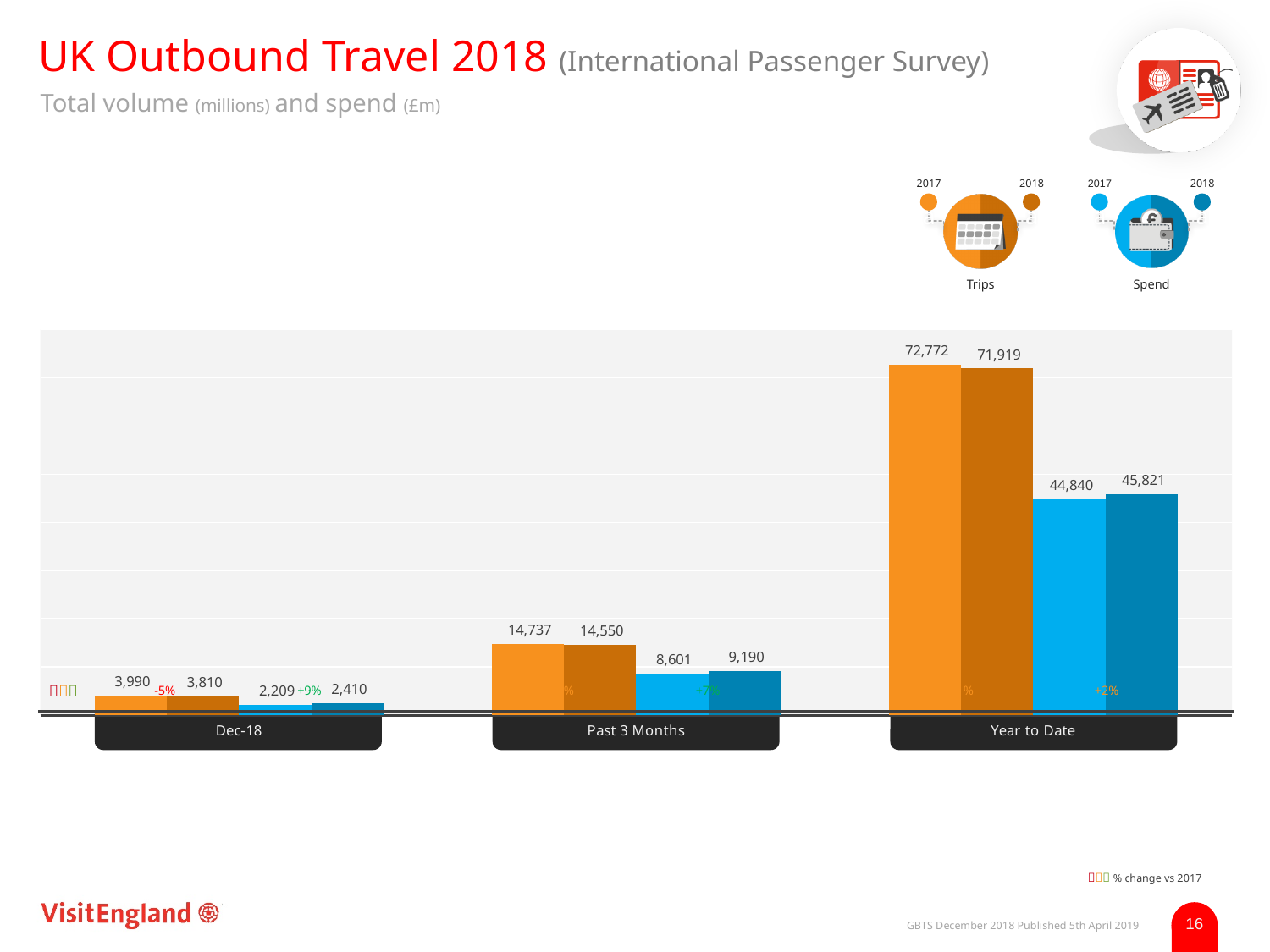
What is the 2017 Trips value for Dec-18? 3,990 What is the 2018 Trips value for Year to Date? 71,919 Which category has the lowest 2018 Spend value? Dec-18 What is the percentage change shown for Dec-18 Trips versus 2017? -5% What is the difference between the 2017 Trips and 2018 Trips values for Year to Date? 853 Which is larger for Dec-18: the 2017 Spend value or the 2018 Spend value? 2018 Spend What is the 2018 Spend value for Dec-18? 2,410 How many categories are shown on the x axis? 3 What is the 2017 Spend value for Past 3 Months? 8,601 What is the difference between the 2018 Spend and 2017 Spend values for Past 3 Months? 589 What kind of chart is shown on the slide? Bar chart Which category has the highest 2017 Trips value? Year to Date